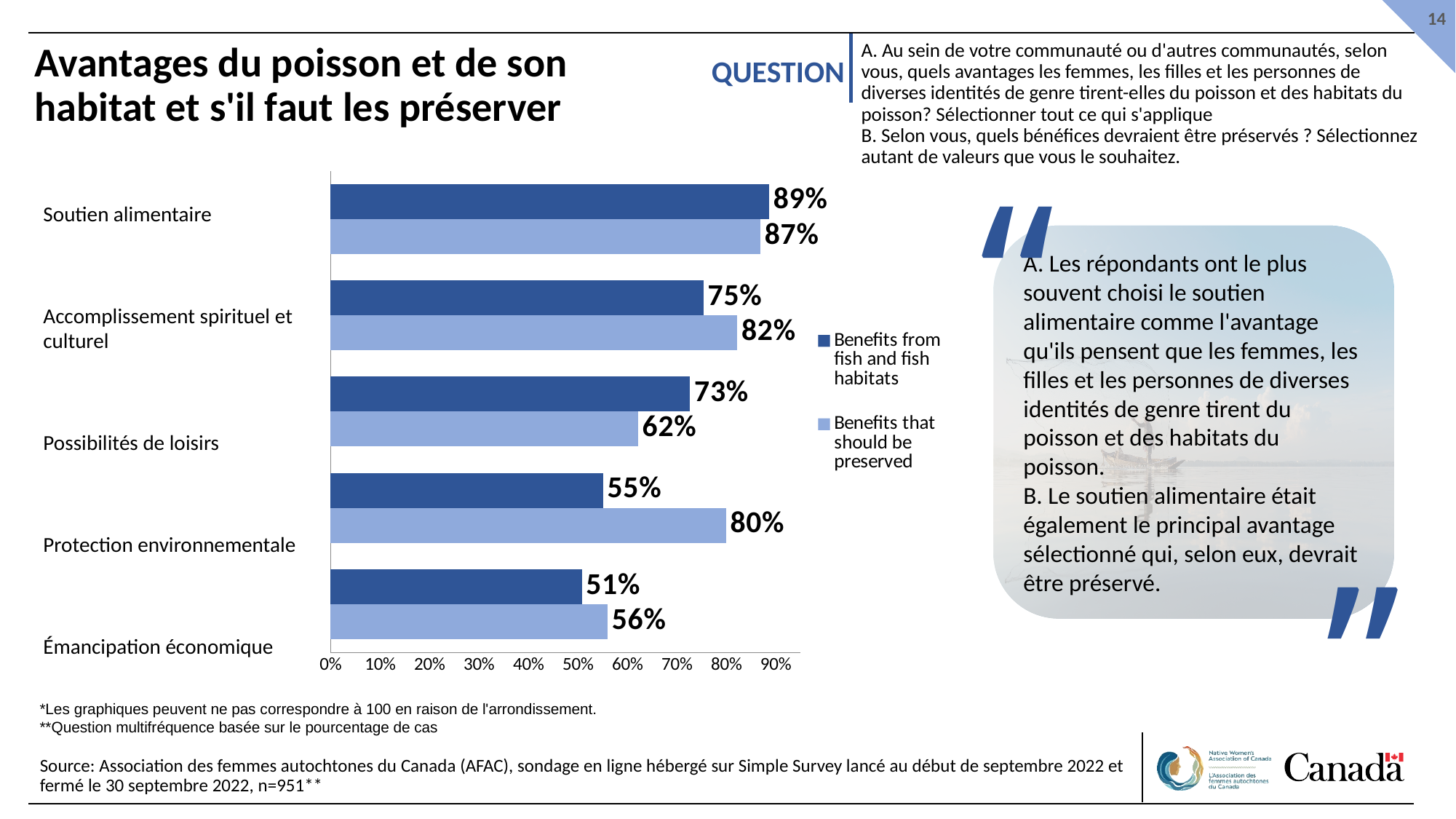
Which category has the highest value in the "Benefits from fish and fish habitats" series? Soutien alimentaire How many categories are shown on the chart? 5 What kind of chart is shown on the slide? Bar chart What is the value for "Protection environnementale" in the "Benefits that should be preserved" series? 80% How many series does the legend list? 2 For "Possibilités de loisirs", which series has the larger value? Benefits from fish and fish habitats What is the value for "Accomplissement spirituel et culturel" in the "Benefits from fish and fish habitats" series? 75% What is the value for "Possibilités de loisirs" in the "Benefits that should be preserved" series? 62% What is the value for "Soutien alimentaire" in the "Benefits from fish and fish habitats" series? 89% What is the difference between the two series for "Soutien alimentaire"? 2% Which category has the lowest value in the "Benefits that should be preserved" series? Émancipation économique What is the difference between the two series for "Protection environnementale"? 25%